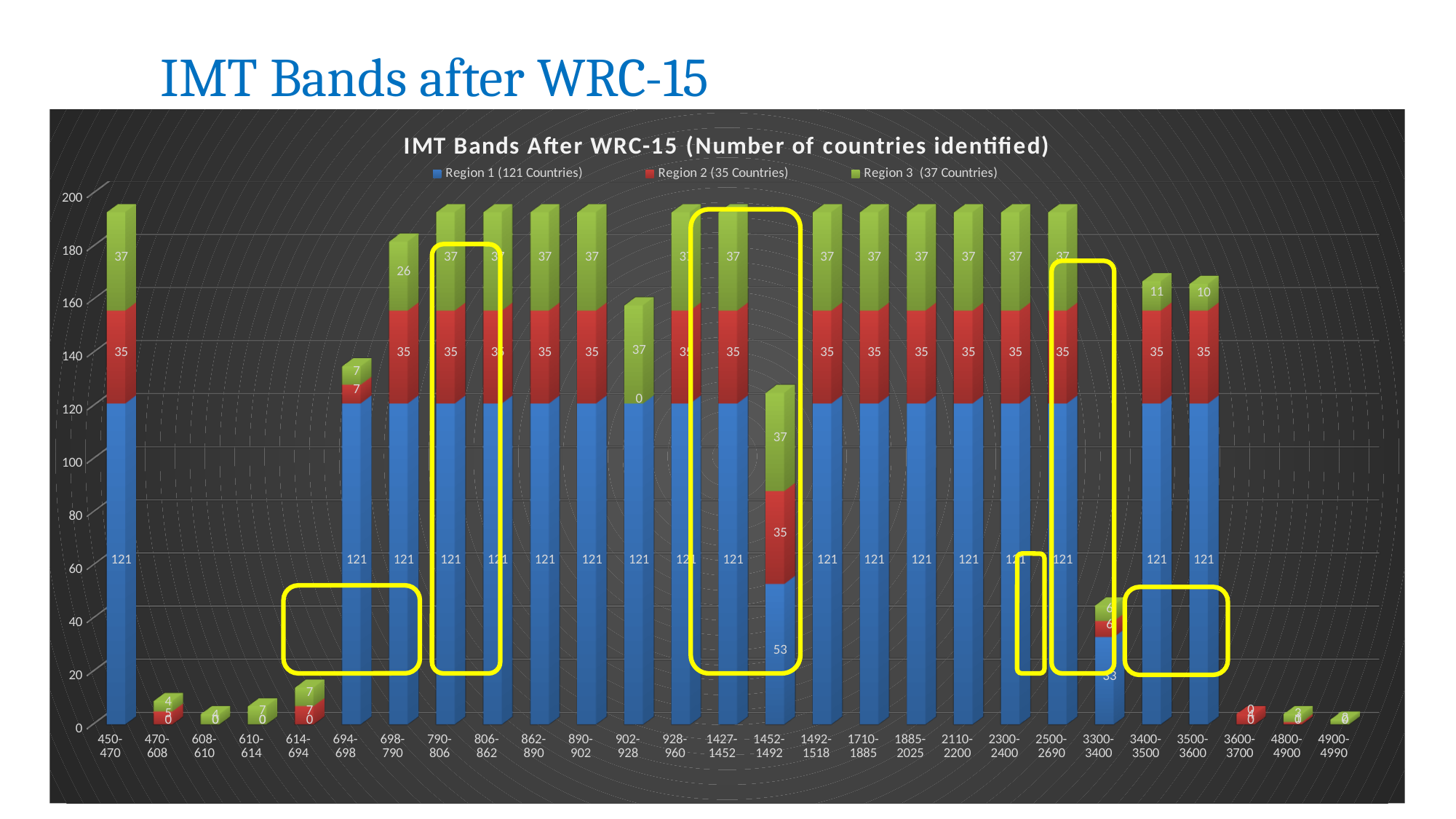
What kind of chart is shown on the slide? Stacked bar chart What is the Region 2 value for the 902-928 band? 0 What is the Region 3 value for the 698-790 band? 26 What is the full legend entry for the red series? Region 2 (35 Countries) How many frequency band categories are shown on the x axis? 27 How many series does the legend list? 3 What is the Region 1 value for the 1452-1492 band? 53 What is the total of the stacked bar for the 698-790 band? 182 What is the Region 3 value for the 3400-3500 band? 11 What is the total of the stacked bar for the 1452-1492 band? 125 What is the difference between the Region 1 value for 450-470 and the Region 1 value for 1452-1492? 68 What is the Region 1 value for the 3300-3400 band? 33